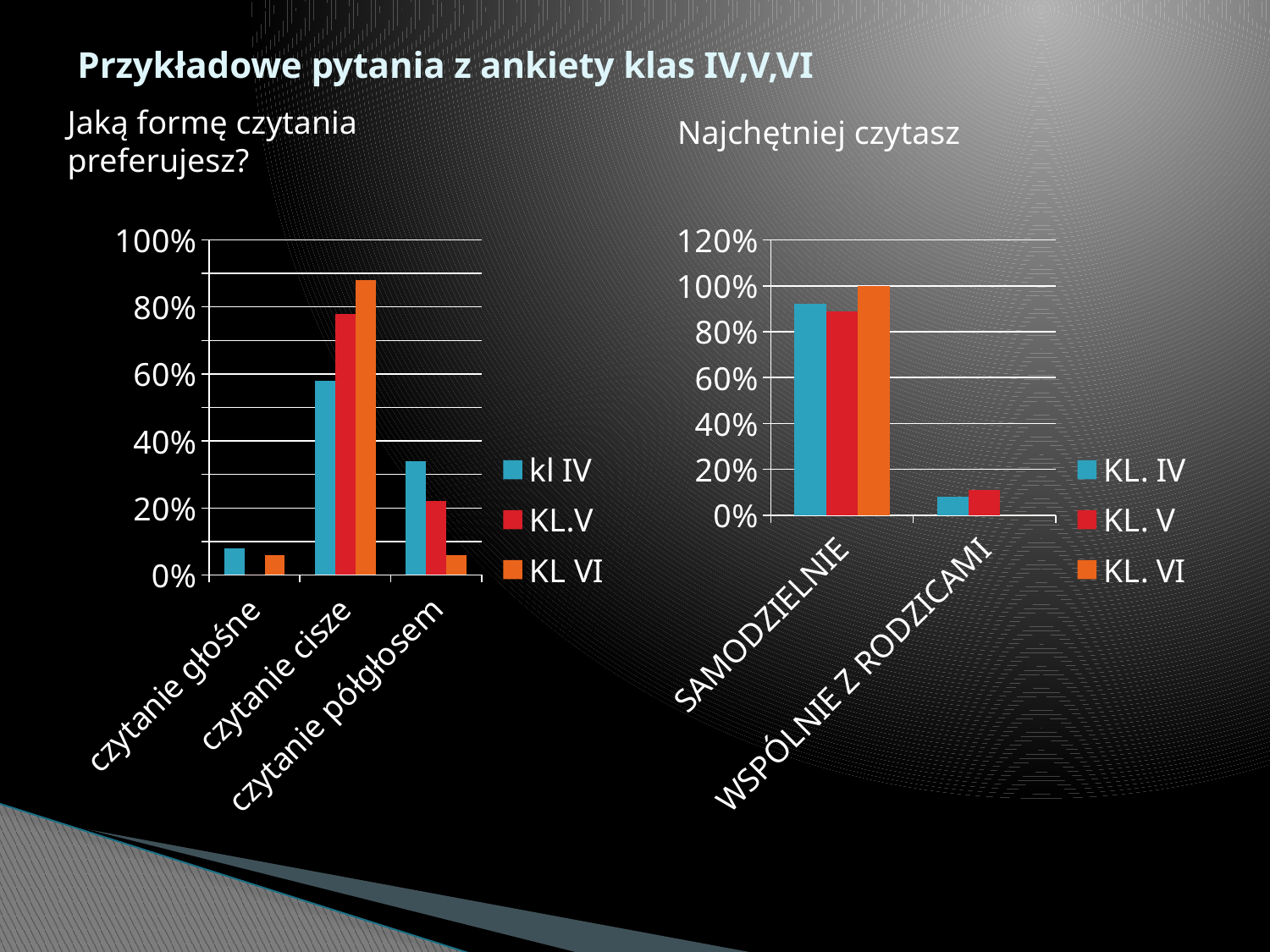
How many series does the legend of the left chart "Jaką formę czytania preferujesz?" list? 3 How many categories are shown on the x axis of the right chart "Najchętniej czytasz"? 2 What kind of chart is the left chart titled "Jaką formę czytania preferujesz?"? bar chart In the right chart "Najchętniej czytasz", what is the value for KL. VI in "SAMODZIELNIE"? 100% In the right chart "Najchętniej czytasz", which category has the larger value for KL. IV: SAMODZIELNIE or WSPÓLNIE Z RODZICAMI? SAMODZIELNIE How many categories are shown on the x axis of the left chart "Jaką formę czytania preferujesz?"? 3 In the right chart "Najchętniej czytasz", is the value for KL. V in "WSPÓLNIE Z RODZICAMI" greater or less than 20%? less In the left chart "Jaką formę czytania preferujesz?", is the value for KL VI in "czytanie cisze" greater or less than 80%? greater In the left chart "Jaką formę czytania preferujesz?", is the value for kl IV in "czytanie cisze" greater or less than 40%? greater In the left chart "Jaką formę czytania preferujesz?", which series has the highest value for "czytanie cisze"? KL VI In the left chart "Jaką formę czytania preferujesz?", which is larger for "czytanie półgłosem": kl IV or KL.V? kl IV What is the title of the chart on the right side of the slide? Najchętniej czytasz